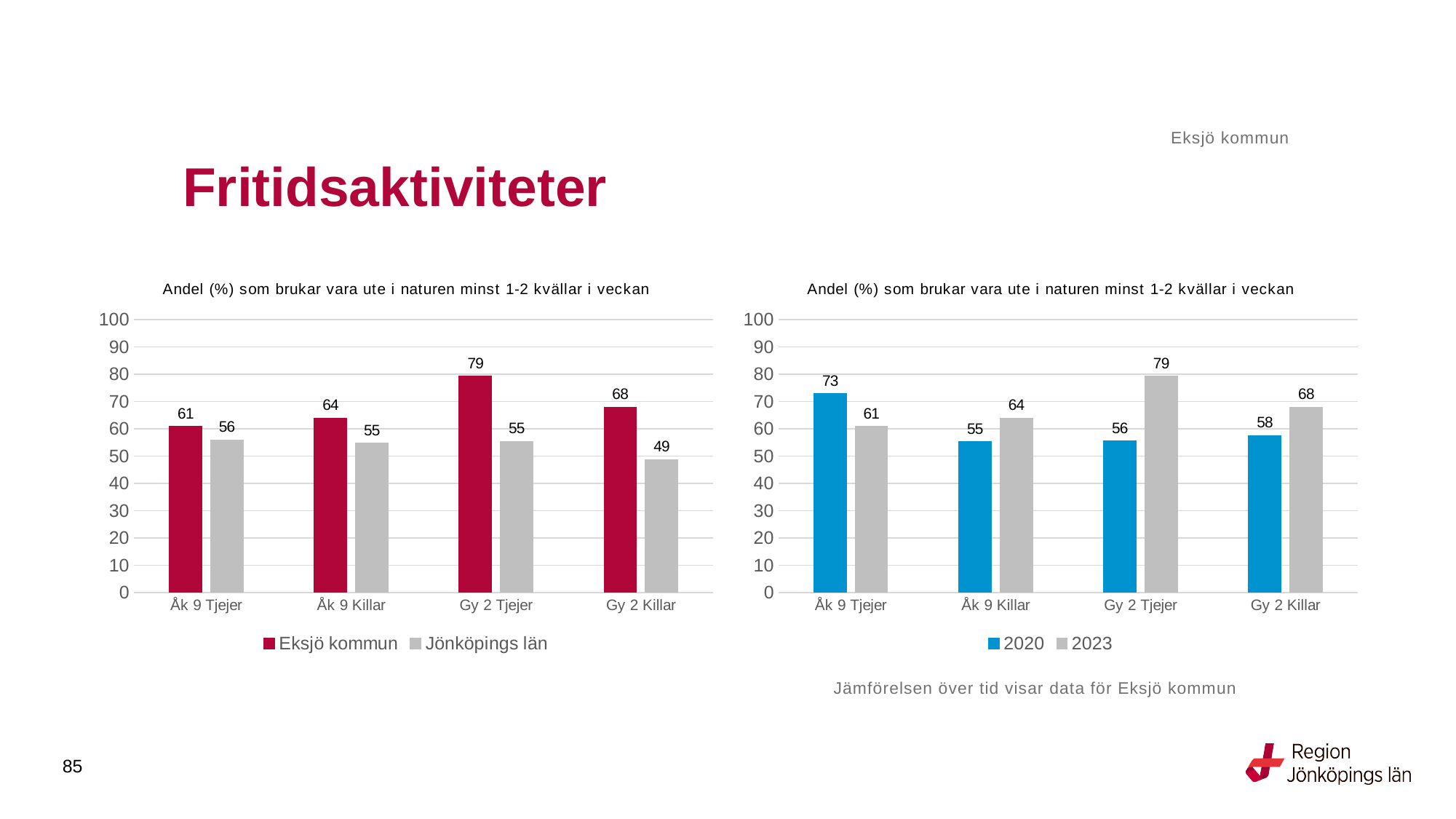
In the right chart, which category has the highest value for 2023? Gy 2 Tjejer In the right chart, what is the value for 2023 for Åk 9 Killar? 64 In the right chart, what is the difference between 2023 and 2020 for Gy 2 Tjejer? 23 In the right chart, what is the value for 2020 for Åk 9 Tjejer? 73 In the left chart, what is the value for Jönköpings län for Gy 2 Killar? 49 What kind of chart is the left chart? Bar chart In the left chart, what is the difference between Eksjö kommun and Jönköpings län for Gy 2 Tjejer? 24 In the left chart, which category has the lowest value for Jönköpings län? Gy 2 Killar In the left chart, what is the value for Eksjö kommun for Gy 2 Tjejer? 79 In the right chart, which is larger for Åk 9 Tjejer, 2020 or 2023? 2020 In the left chart, how many series does the legend list? 2 How many categories are shown on the x axis of the right chart? 4